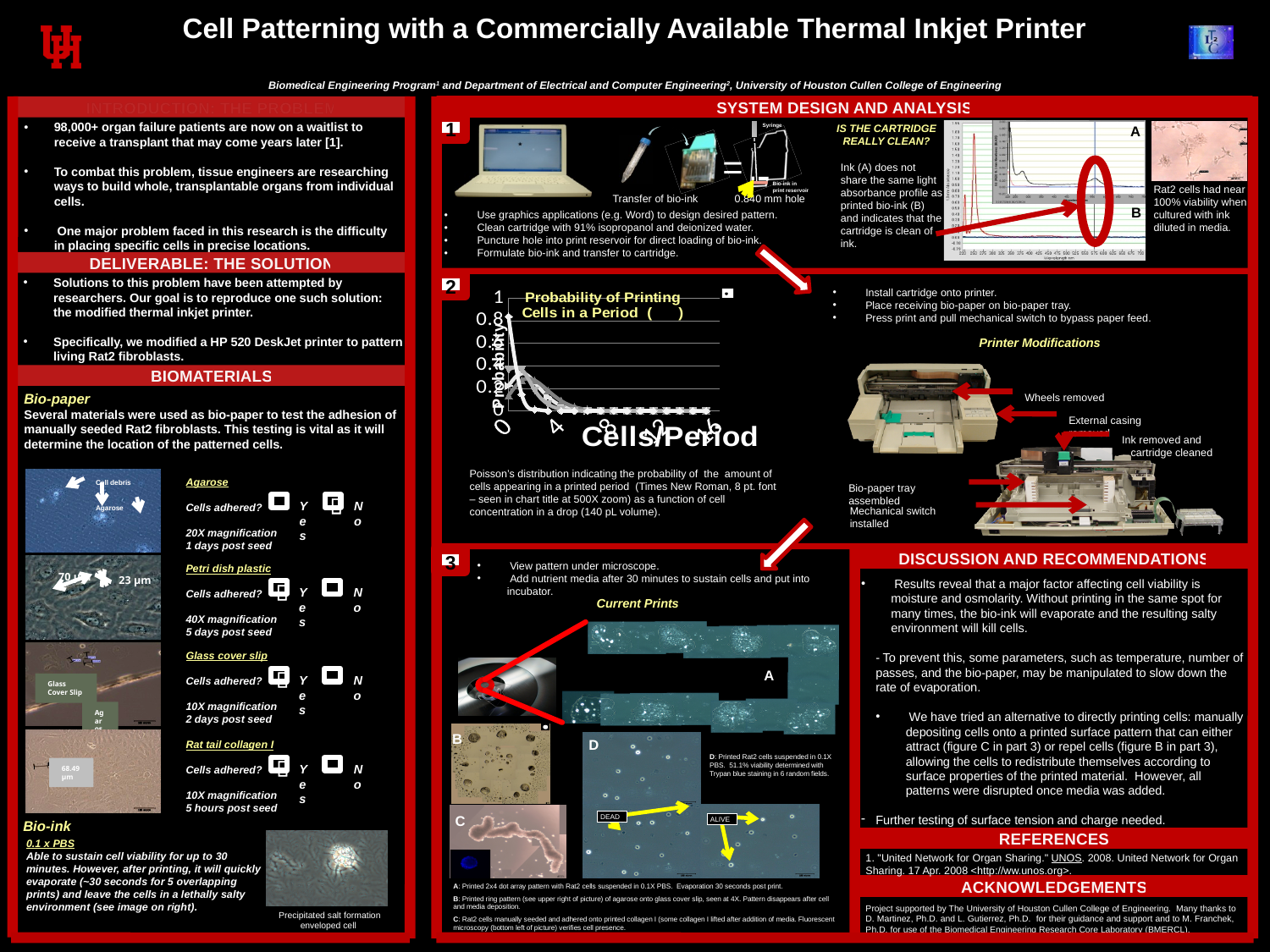
What is the label of the y axis on the "Probability of Printing Cells in a Period" chart? Probability What is the title of the chart in section 2 of the poster? Probability of Printing Cells in a Period ( ) What is the label of the x axis on the "Probability of Printing Cells in a Period" chart? Cells/Period What kind of chart is the "Probability of Printing Cells in a Period" chart? line chart On the "Probability of Printing Cells in a Period" chart, do the plotted values rise or fall as Cells/Period increases? fall On the "Probability of Printing Cells in a Period" chart, are the plotted values at 8 Cells/Period greater or less than 0.2? less